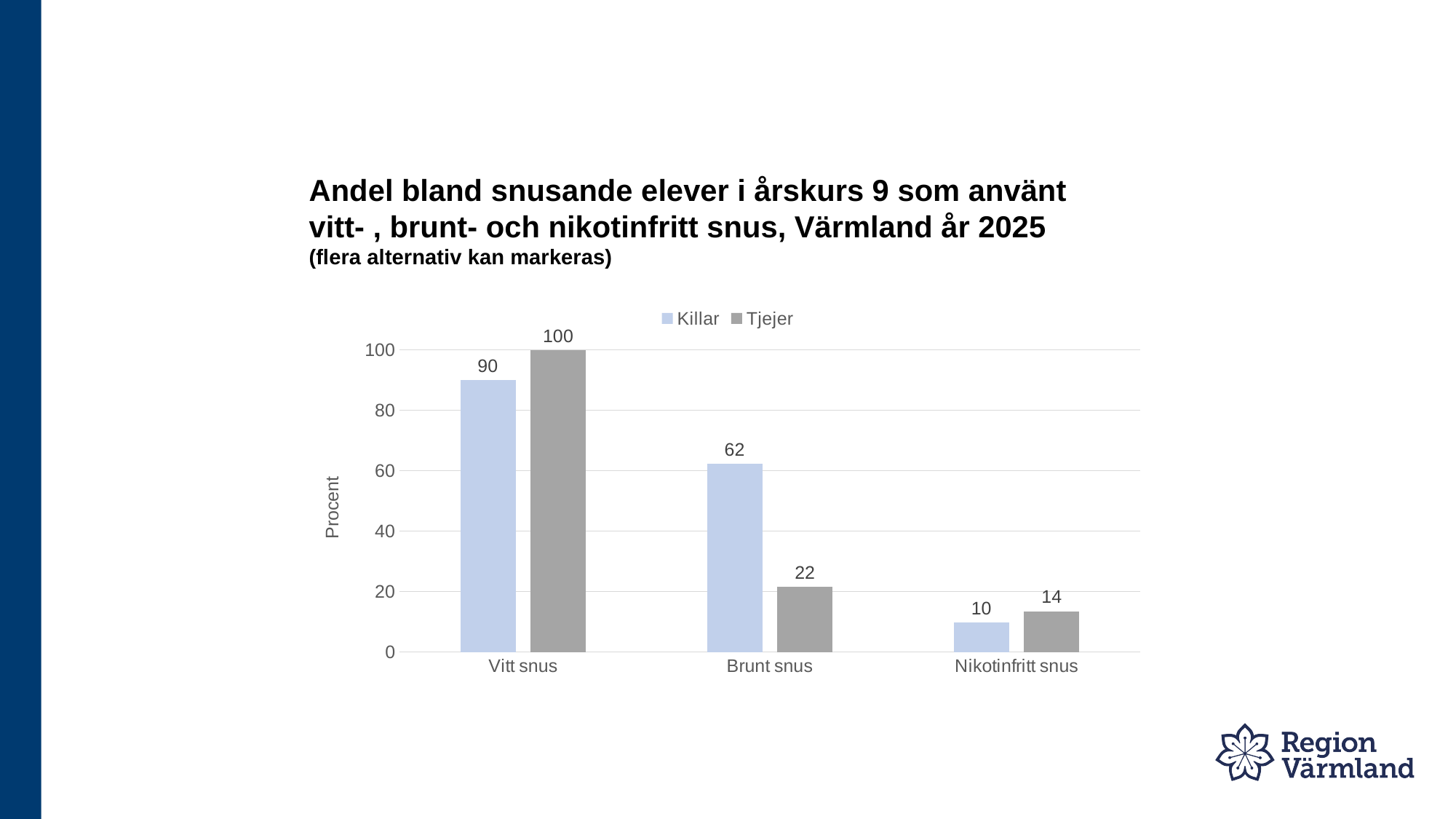
What is the label of the y axis? Procent Which category has the lowest value for Killar? Nikotinfritt snus Which is larger for Nikotinfritt snus, Killar or Tjejer? Tjejer What kind of chart is shown on the slide? bar chart Is the value for Tjejer for Brunt snus greater or less than 40? less What is the value for Killar for Nikotinfritt snus? 10 What is the value for Tjejer for Brunt snus? 22 How many series does the legend list? 2 How many categories are shown on the x axis? 3 What is the difference between Killar and Tjejer for Brunt snus? 40 Which category has the highest value for Tjejer? Vitt snus What is the value for Killar for Vitt snus? 90